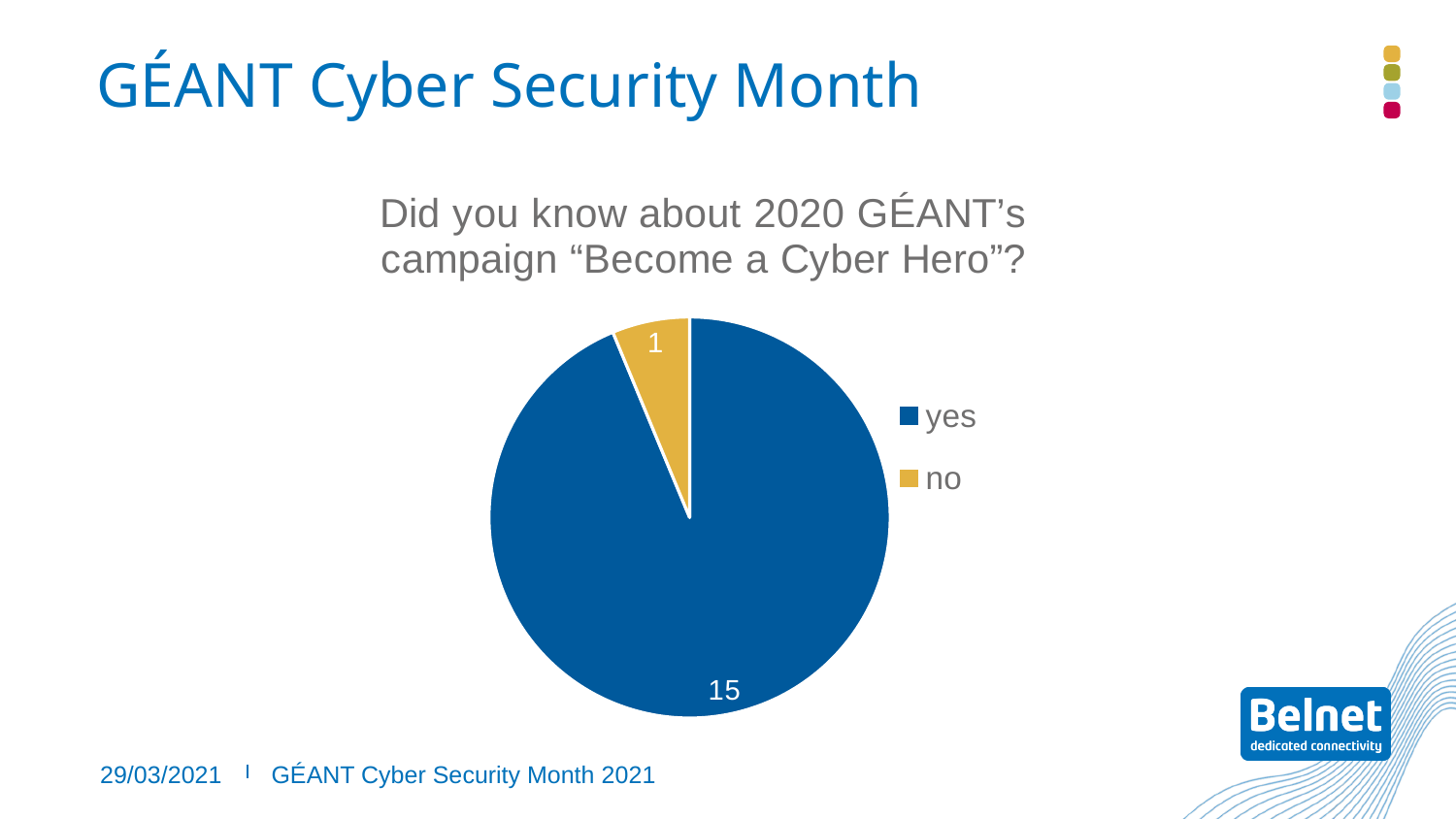
What question does the pie chart summarise responses to? Did you know about 2020 GÉANT's campaign "Become a Cyber Hero"? How many entries does the legend list? 2 Which is larger, the value for "yes" or the value for "no"? yes What is the total number of responses shown in the pie chart? 16 What is the difference between the number of "yes" and "no" answers? 14 Which answer has the largest slice of the pie? yes How many respondents answered "yes"? 15 How many respondents answered "no"? 1 What kind of chart is shown on the slide? pie chart Which answer has the smallest slice of the pie? no What colour is the "no" slice in the pie chart? yellow How many slices does the pie chart have? 2